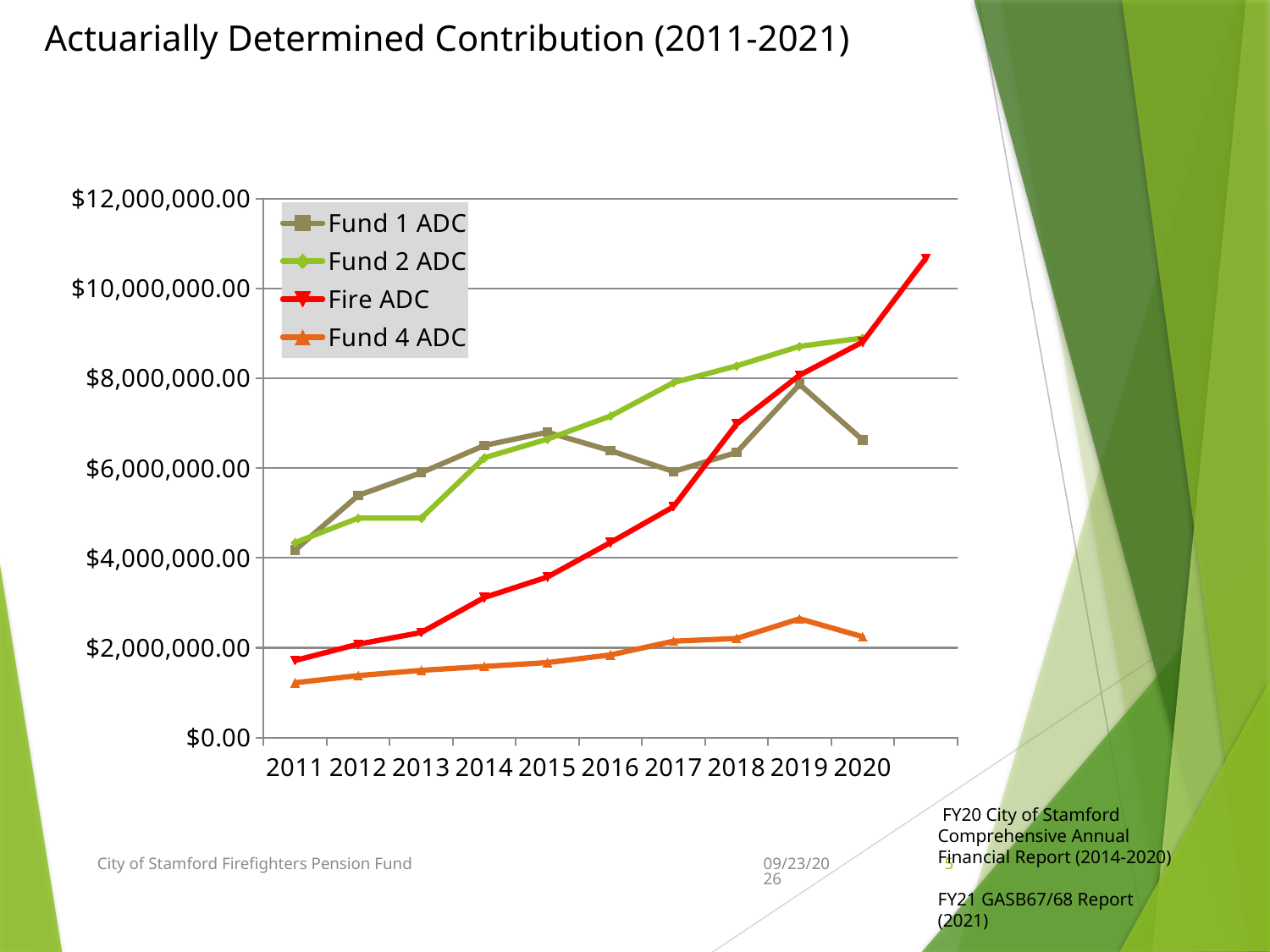
What is the title of the chart? Actuarially Determined Contribution (2011-2021) In 2019, which is higher, Fund 1 ADC or Fund 2 ADC? Fund 2 ADC How many years are labeled on the x axis? 10 Which series reaches the highest value anywhere on the chart? Fire ADC Is the value for Fund 2 ADC in 2020 greater or less than $8,000,000.00? greater Which series has the lowest values across all years shown? Fund 4 ADC Is the value for Fire ADC in 2011 greater or less than $2,000,000.00? less Is the value for Fund 4 ADC in 2019 greater or less than $2,000,000.00? greater What kind of chart is shown on the slide? Line chart How many series does the legend list? 4 Does the Fund 4 ADC line rise or fall from 2011 to 2019? rise